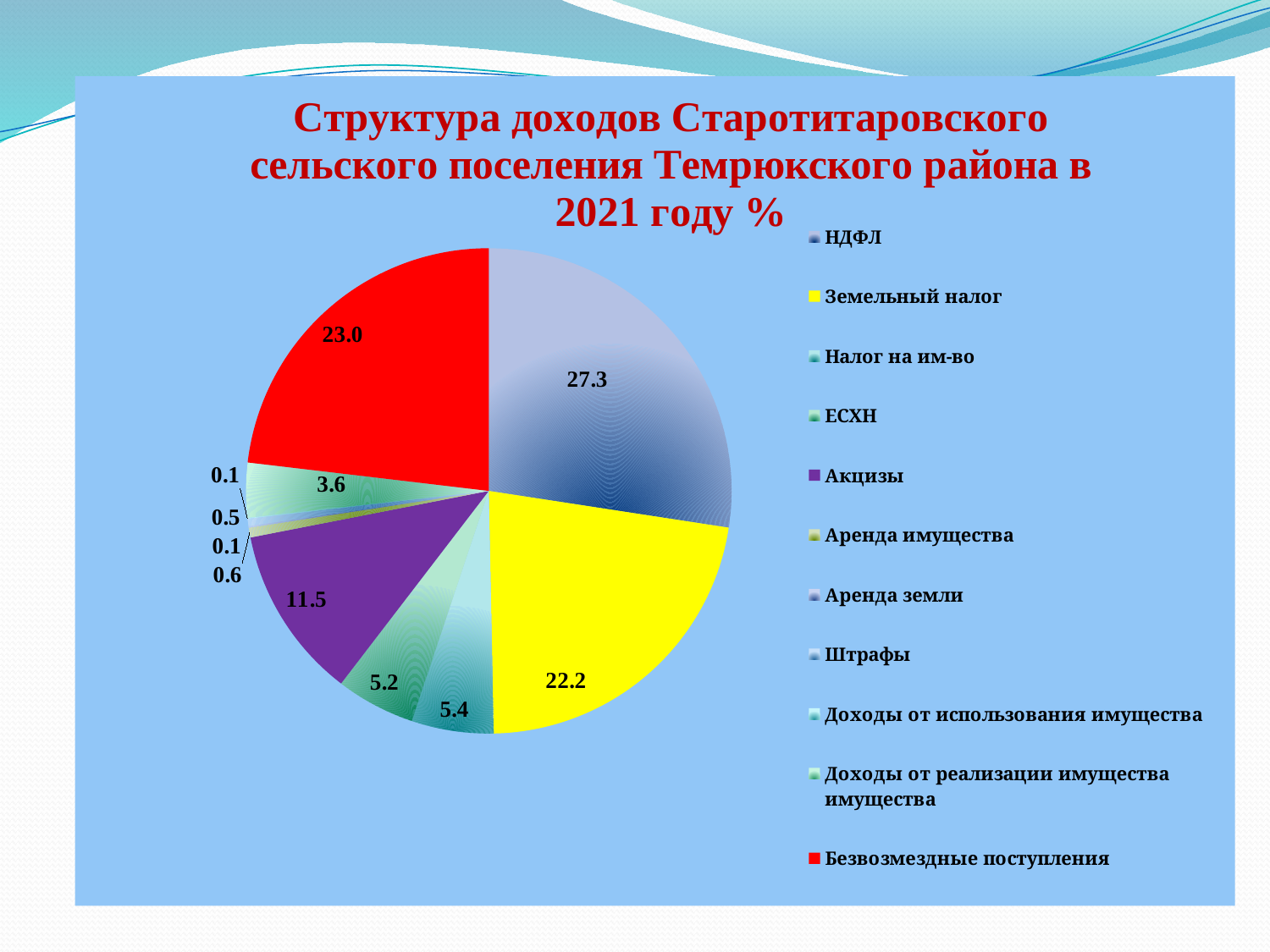
What kind of chart is shown on the slide? pie chart What is the value shown for Налог на им-во? 5.4 How many entries does the legend list? 11 Which category has the largest slice of the pie? НДФЛ What colour is the slice for Безвозмездные поступления? red What is the value shown for Акцизы? 11.5 Which is larger, Безвозмездные поступления or Земельный налог? Безвозмездные поступления What is the value shown for Безвозмездные поступления? 23.0 What is the difference between the values for Безвозмездные поступления and Акцизы? 11.5 What is the value shown for Земельный налог? 22.2 What is the difference between the values for НДФЛ and Земельный налог? 5.1 What is the value shown for НДФЛ? 27.3